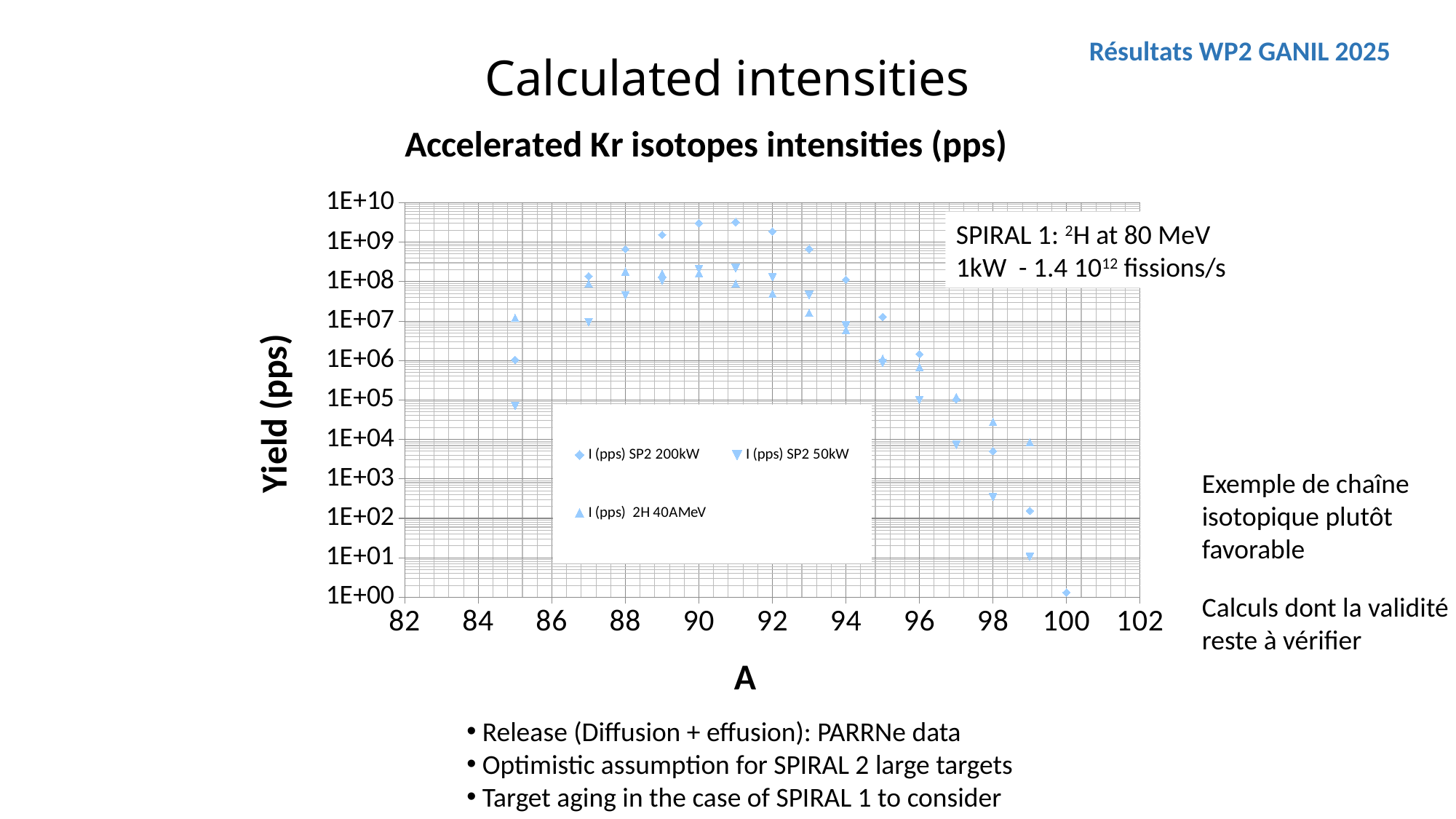
At A = 97, which series has the larger value: I (pps) 2H 40AMeV or I (pps) SP2 50kW? I (pps) 2H 40AMeV What kind of chart is shown on the slide? scatter chart Is the value for I (pps) SP2 200kW at A = 100 greater or less than 1E+01? less Do the values for I (pps) SP2 200kW rise or fall as A increases from 92 to 100? fall Is the value for I (pps) SP2 200kW at A = 95 greater or less than 1E+06? greater Is the value for I (pps) SP2 200kW at A = 90 greater or less than 1E+09? greater What is the label of the y axis? Yield (pps) How many series does the chart legend list? 3 At A = 94, which series has the larger value: I (pps) SP2 200kW or I (pps) SP2 50kW? I (pps) SP2 200kW What is the title of the chart? Accelerated Kr isotopes intensities (pps)